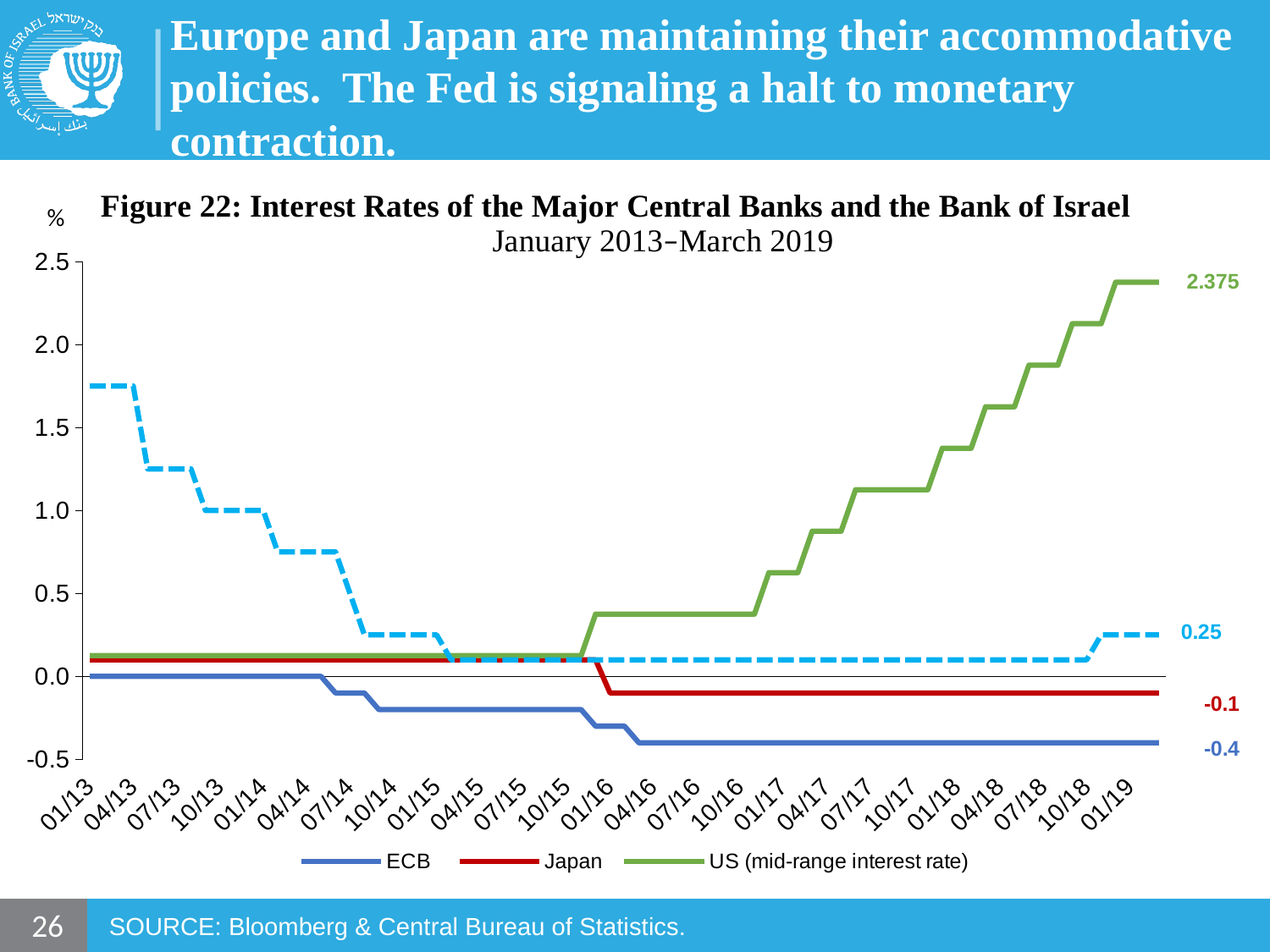
What is the difference between the final US (mid-range interest rate) value and the final ECB value? 2.775 Which series in the legend has the highest interest rate at the end of the period? US (mid-range interest rate) What is the final value shown for the US (mid-range interest rate) line? 2.375 Does the US (mid-range interest rate) line rise or fall over the period from 2016 to 2019? rise Is the US (mid-range interest rate) value at 01/18 greater or less than 1.0? greater What is the final value shown for the ECB line? -0.4 What kind of chart is shown in Figure 22? line chart What is the final value shown for the Japan line? -0.1 How many series does the legend of Figure 22 list? 3 What colour is the US (mid-range interest rate) line in the chart? green Which series in the legend has the lowest interest rate at the end of the period? ECB At the end of the period, which is larger: the Japan rate or the ECB rate? Japan